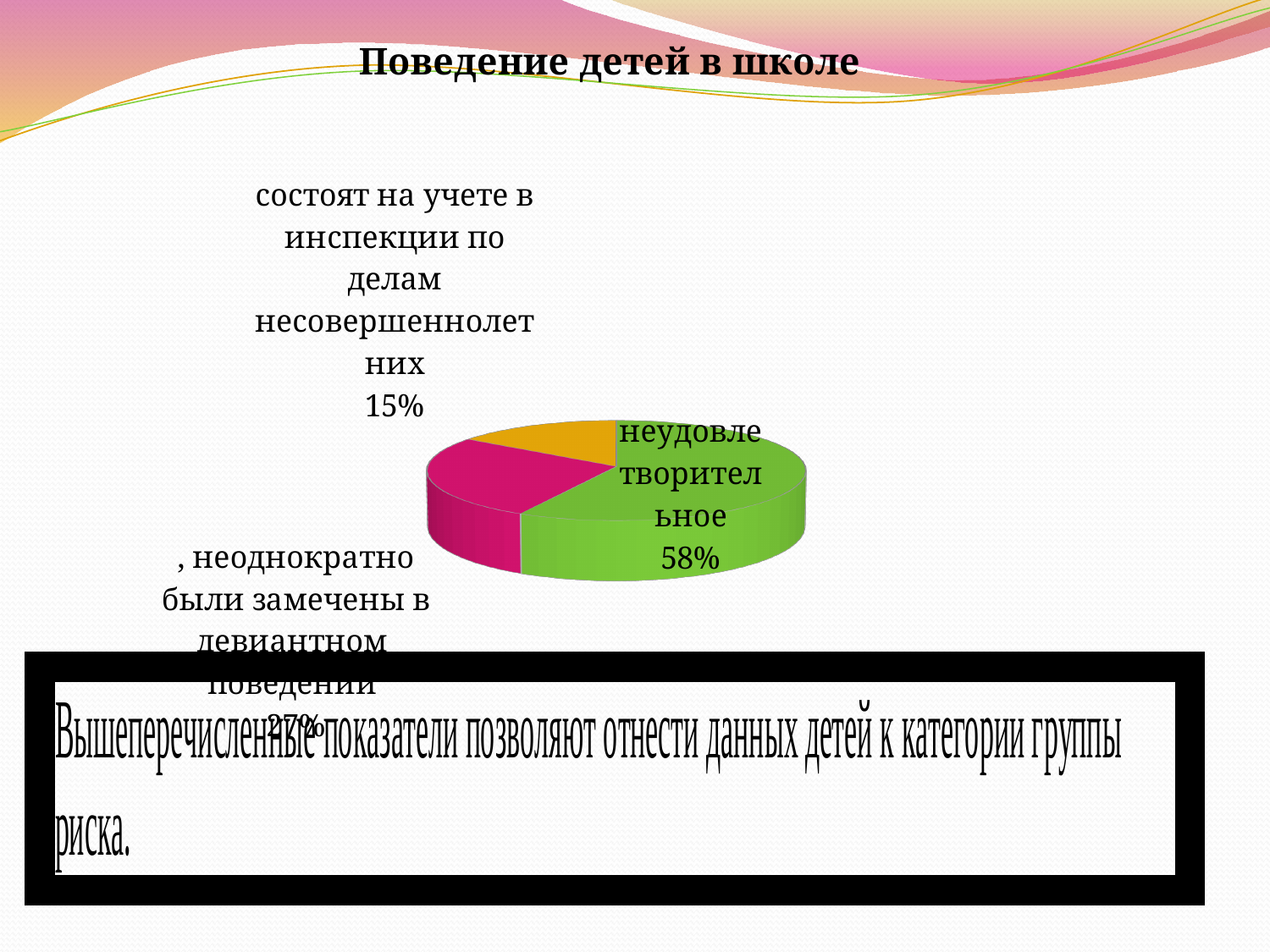
Which slice of the pie is the smallest? состоят на учете в инспекции по делам несовершеннолетних What is the title of the chart? Поведение детей в школе What colour is the "неудовлетворительное" slice? green What share of the pie does the "неудовлетворительное" slice represent? 58% What percentage of the pie is labelled "неоднократно были замечены в девиантном поведении"? 27% What is the difference in percentage points between the "неудовлетворительное" slice and the "состоят на учете в инспекции по делам несовершеннолетних" slice? 43 What percentage of the pie is labelled "состоят на учете в инспекции по делам несовершеннолетних"? 15% Which is larger: the "неудовлетворительное" slice or the "неоднократно были замечены в девиантном поведении" slice? неудовлетворительное What percentage of the pie is labelled "неудовлетворительное"? 58% Which slice of the pie is the largest? неудовлетворительное How many slices does the pie chart have? 3 What kind of chart is shown on the slide? pie chart